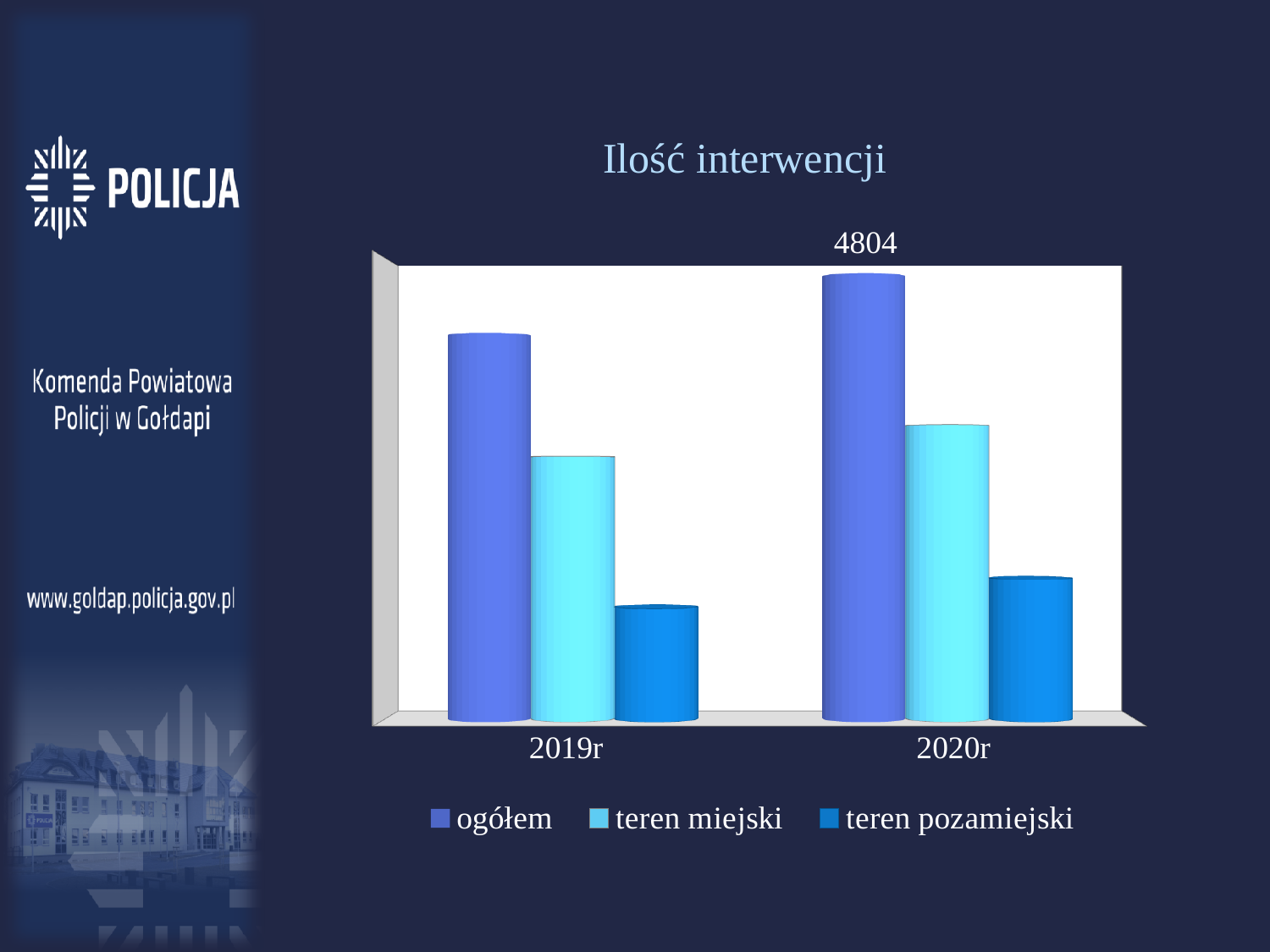
Does the value for ogółem rise or fall from 2019r to 2020r? rise Which series has the highest bar in 2020r? ogółem What is the value of ogółem for 2020r? 4804 Which year has the larger value for teren pozamiejski, 2019r or 2020r? 2020r Which series has the lowest bar in 2019r? teren pozamiejski Which year has the larger value for ogółem, 2019r or 2020r? 2020r Which series is shown in the lightest (cyan) colour in the legend? teren miejski What is the title of the chart? Ilość interwencji Which year has the larger value for teren miejski, 2019r or 2020r? 2020r How many series does the legend list? 3 What kind of chart is shown on the slide? bar chart How many categories (years) are shown on the x axis? 2